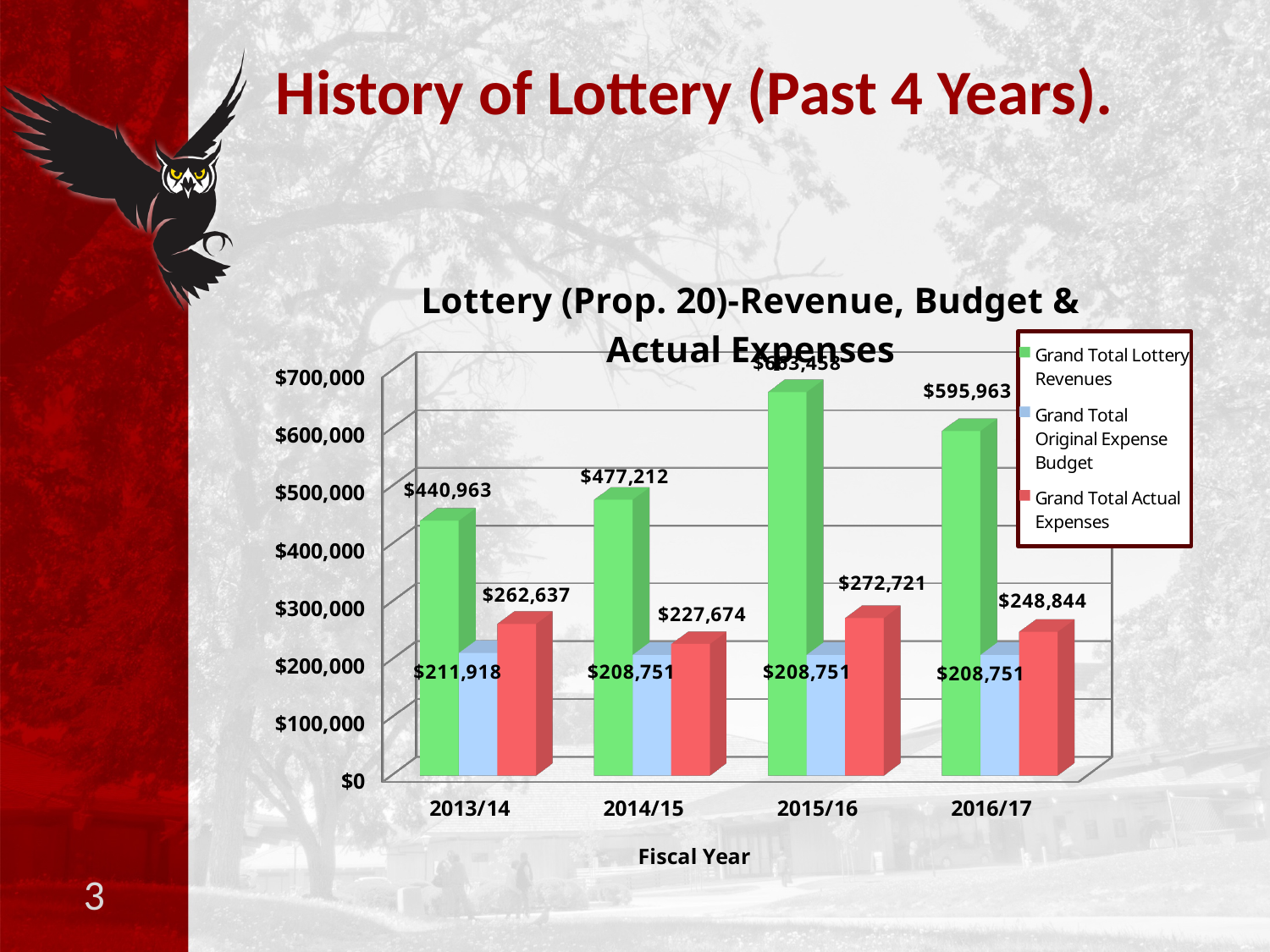
Which is larger in 2014/15: Grand Total Actual Expenses or Grand Total Original Expense Budget? Grand Total Actual Expenses What is the Grand Total Lottery Revenues value for 2016/17? $595,963 Which fiscal year has the lowest Grand Total Actual Expenses? 2014/15 What is the Grand Total Lottery Revenues value for 2013/14? $440,963 What type of chart is shown on the slide? Bar chart Which fiscal year has the highest Grand Total Lottery Revenues? 2015/16 How many fiscal years are shown on the x axis? 4 Is the Grand Total Lottery Revenues value for 2015/16 greater or less than $600,000? greater What is the Grand Total Actual Expenses value for 2015/16? $272,721 What is the difference between Grand Total Actual Expenses and Grand Total Original Expense Budget in 2016/17? $40,093 How many series does the legend list? 3 What is the Grand Total Original Expense Budget value for 2013/14? $211,918